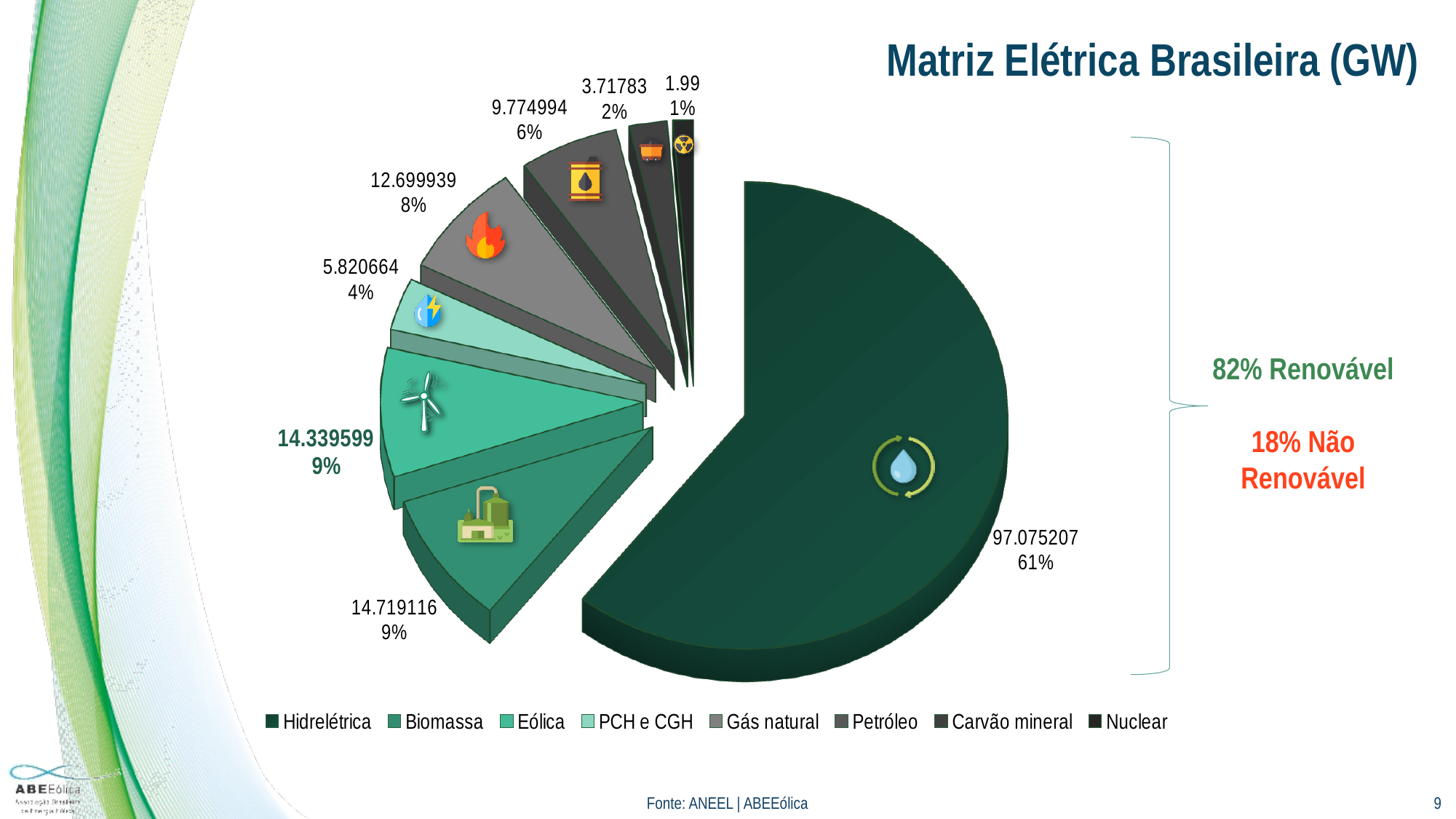
What is the title of the chart? Matriz Elétrica Brasileira (GW) What share of the pie does Hidrelétrica represent? 61% Which category has the smallest slice? Nuclear What is the value for Hidrelétrica? 97.075207 What type of chart is shown on the slide? Pie chart What share of the pie does Eólica represent? 9% Which is larger, the value for PCH e CGH or the value for Petróleo? Petróleo How many slices does the pie chart have? 8 What is the difference between the values for Gás natural and Petróleo? 2.924945 What is the value for Gás natural? 12.699939 According to the annotation on the right, what percentage of the matrix is renewable (Renovável)? 82% Which category has the largest slice? Hidrelétrica